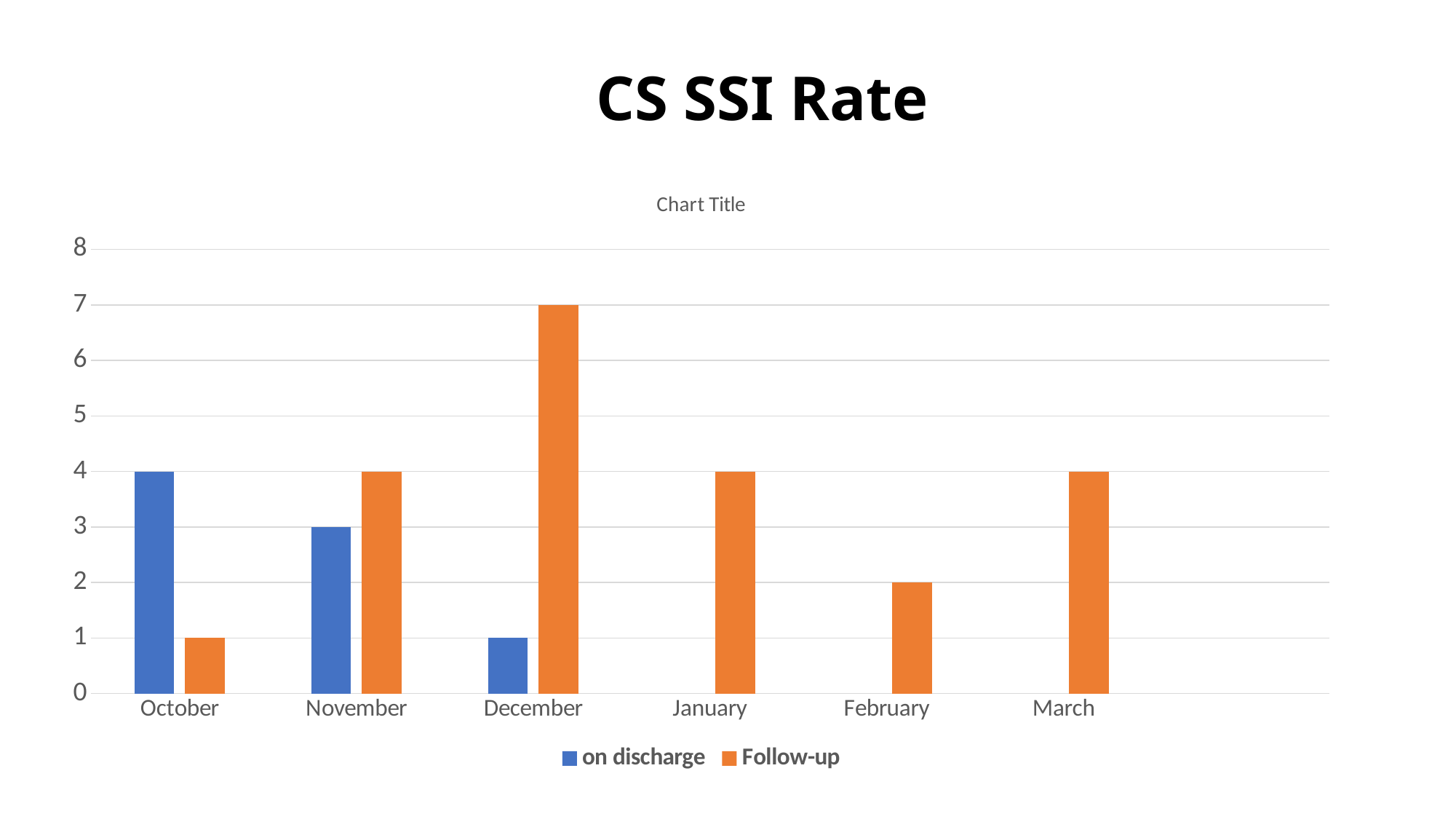
Is the Follow-up value for December greater or less than 6? greater Which month has the lowest Follow-up value? October Which is larger for October, the on discharge value or the Follow-up value? on discharge Which month has the highest Follow-up value? December What is the title shown at the top of the slide? CS SSI Rate How many series does the legend list? 2 What is the difference between the Follow-up and on discharge values for December? 6 What type of chart is shown on the slide? bar chart What is the on discharge value for October? 4 What is the Follow-up value for February? 2 What is the Follow-up value for December? 7 How many months are shown on the x axis? 6